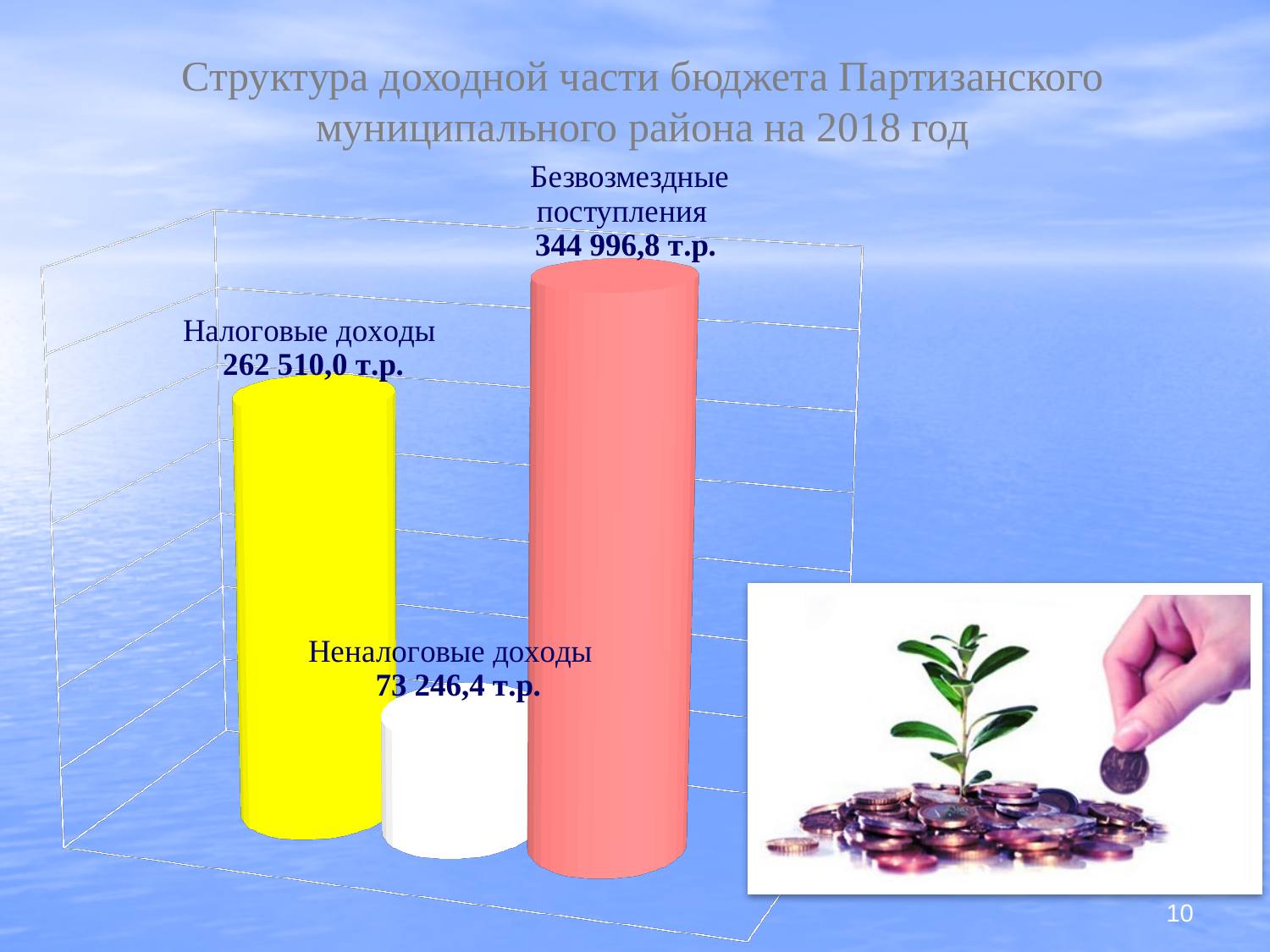
What kind of chart is shown on the slide? Bar chart Which category has the highest value? Безвозмездные поступления What is the value shown for Неналоговые доходы? 73 246,4 т.р. What colour is the bar for Налоговые доходы? Yellow What is the difference between Налоговые доходы and Неналоговые доходы? 189 263,6 т.р. What is the value shown for Налоговые доходы? 262 510,0 т.р. What is the difference between Безвозмездные поступления and Налоговые доходы? 82 486,8 т.р. How many categories are shown in the chart? 3 Which category has the lowest value? Неналоговые доходы Which is larger, Безвозмездные поступления or Налоговые доходы? Безвозмездные поступления What is the value shown for Безвозмездные поступления? 344 996,8 т.р. Which is larger, Налоговые доходы or Неналоговые доходы? Налоговые доходы